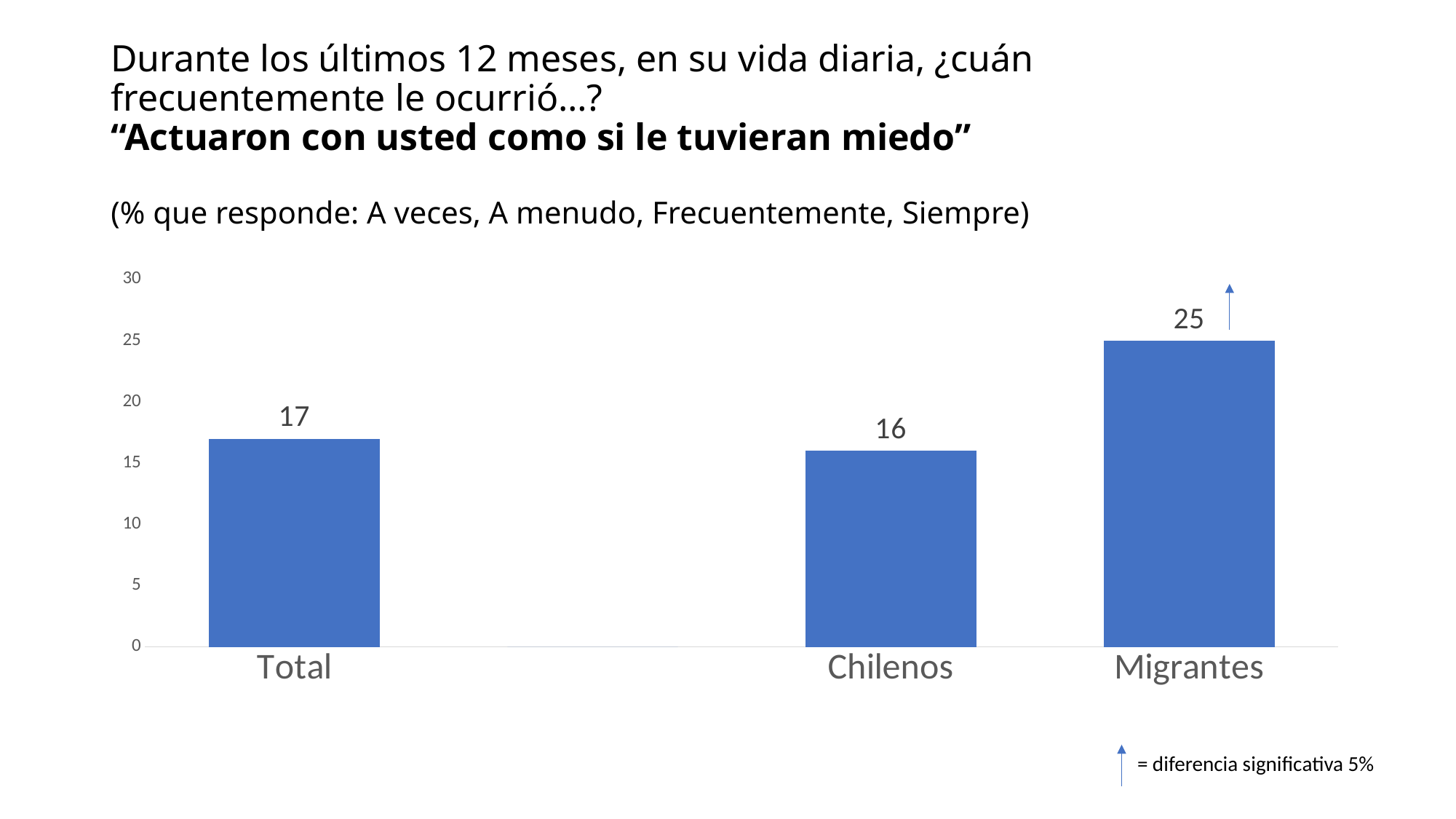
What does the arrow symbol next to the Migrantes bar indicate, according to the legend note? diferencia significativa 5% What is the value for Migrantes? 25 What is the difference between the values for Migrantes and Chilenos? 9 Which category has the highest value? Migrantes What is the difference between the values for Total and Chilenos? 1 Which is larger, the value for Migrantes or the value for Total? Migrantes What kind of chart is shown on the slide? bar chart Is the value for Migrantes greater or less than 20? greater Which category has the lowest value? Chilenos What is the value for Total? 17 What is the value for Chilenos? 16 How many categories are shown on the x axis? 3